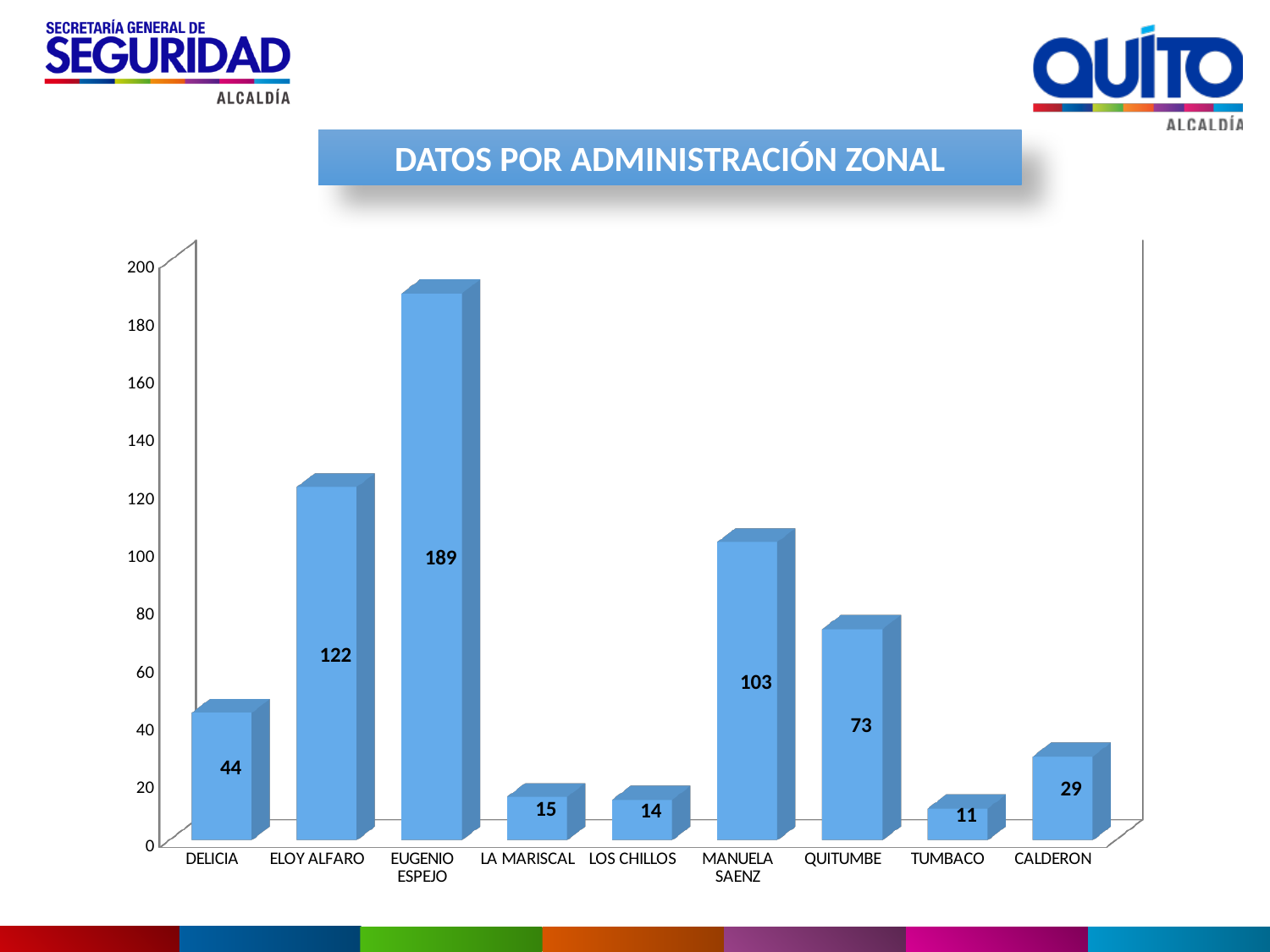
Which administración zonal has the highest value? EUGENIO ESPEJO What is the difference between the values for LA MARISCAL and LOS CHILLOS? 1 What kind of chart is shown on the slide? bar chart Which is larger, the value for DELICIA or the value for CALDERON? DELICIA What is the value for EUGENIO ESPEJO? 189 What is the value for MANUELA SAENZ? 103 What is the title of the slide above the chart? DATOS POR ADMINISTRACIÓN ZONAL How many administraciones zonales are shown on the x axis? 9 What is the value for TUMBACO? 11 Which administración zonal has the lowest value? TUMBACO What is the difference between the values for ELOY ALFARO and QUITUMBE? 49 Is the value for MANUELA SAENZ greater or less than 100? greater